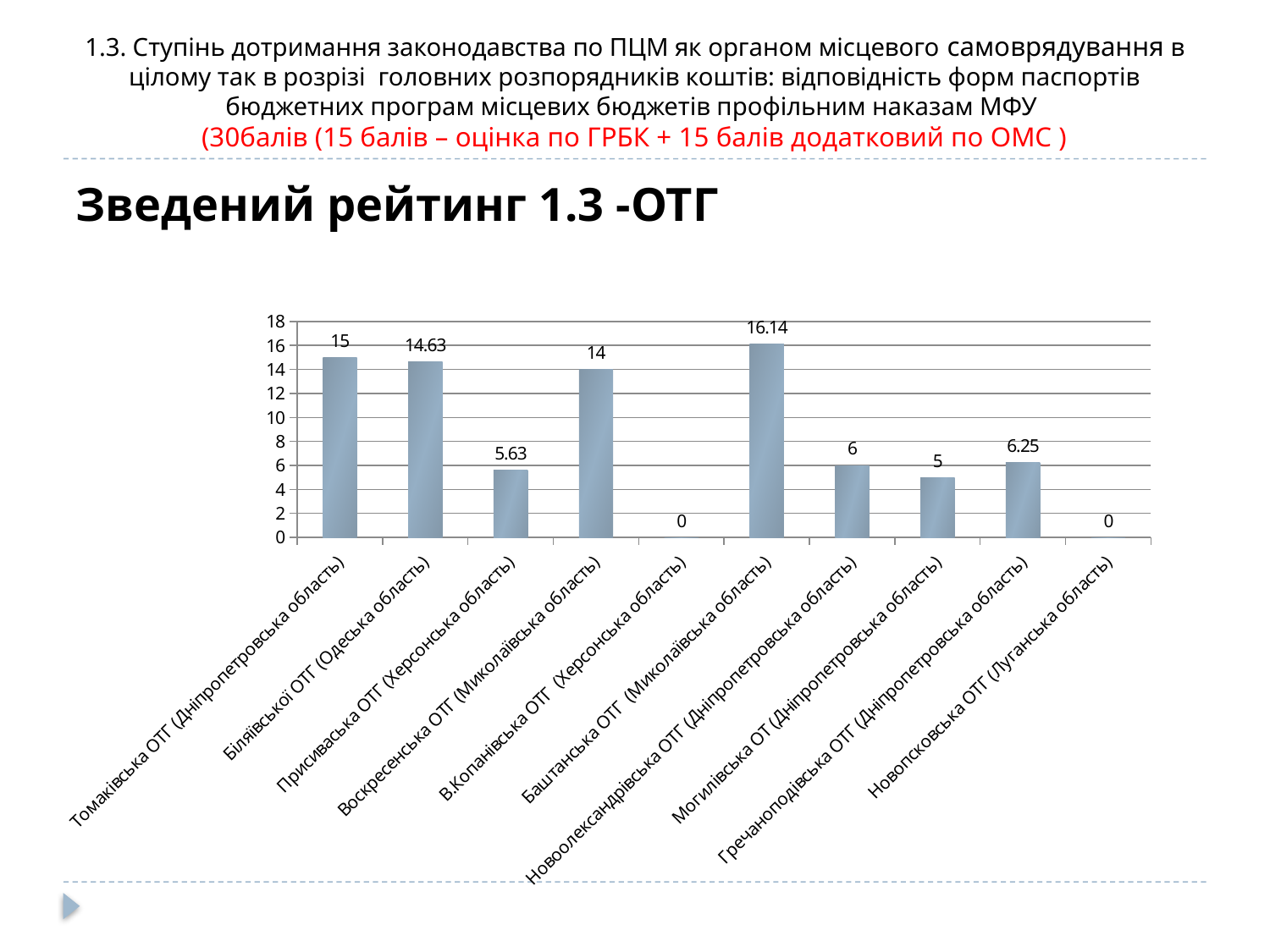
What is the value for Гречаноподівська ОТГ (Дніпропетровська область)? 6.25 What is the value for Баштанська ОТГ (Миколаївська область)? 16.14 Which category has the highest value? Баштанська ОТГ (Миколаївська область) Which is larger, the value for Новоолександрівська ОТГ (Дніпропетровська область) or Могилівська ОТ (Дніпропетровська область)? Новоолександрівська ОТГ (Дніпропетровська область) What is the difference between the values for Баштанська ОТГ (Миколаївська область) and Томаківська ОТГ (Дніпропетровська область)? 1.14 How many categories are shown on the x axis? 10 What is the value for Томаківська ОТГ (Дніпропетровська область)? 15 What kind of chart is shown on the slide? bar chart What is the value for Присиваська ОТГ (Херсонська область)? 5.63 How many categories have a value of 0? 2 Is the value for Воскресенська ОТГ (Миколаївська область) greater or less than 10? greater What is the difference between the values for Біляївської ОТГ (Одеська область) and Воскресенська ОТГ (Миколаївська область)? 0.63